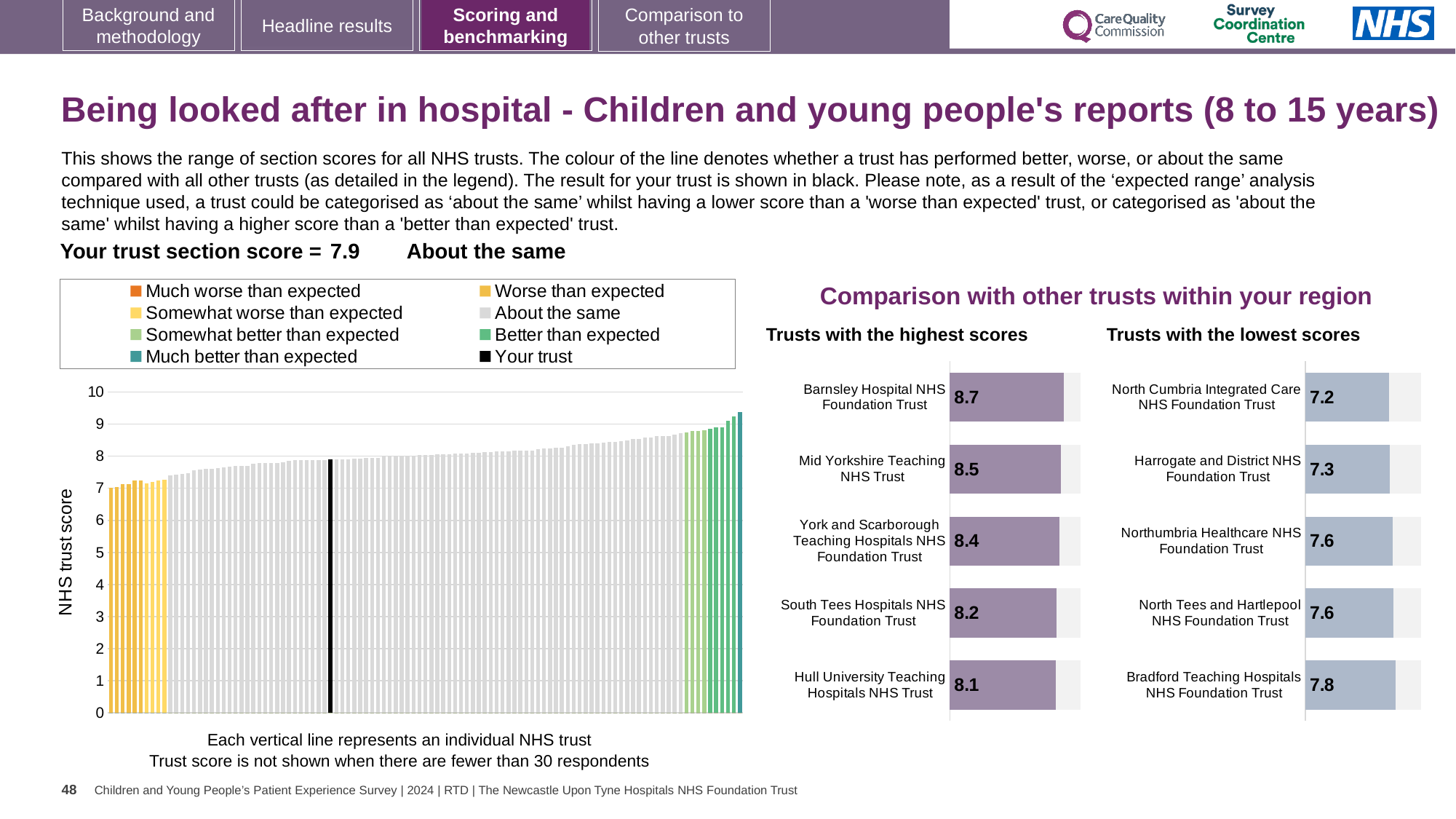
In the 'Trusts with the lowest scores' chart, what is the difference between the scores of Bradford Teaching Hospitals NHS Foundation Trust and North Cumbria Integrated Care NHS Foundation Trust? 0.6 In the 'Trusts with the highest scores' chart, what is the difference between the scores of Barnsley Hospital NHS Foundation Trust and South Tees Hospitals NHS Foundation Trust? 0.5 In the main chart on the left showing all NHS trusts, what is the section score for your trust (the black line)? 7.9 In the 'Trusts with the lowest scores' chart, which trust has the highest score shown? Bradford Teaching Hospitals NHS Foundation Trust In the main chart on the left, do the trust scores rise or fall from left to right? rise In the 'Trusts with the highest scores' chart, which trust has the lowest score shown? Hull University Teaching Hospitals NHS Trust How many entries does the legend of the main chart on the left list? 8 How many trusts are listed in the 'Trusts with the highest scores' chart? 5 In the 'Trusts with the highest scores' chart, what is the score for Barnsley Hospital NHS Foundation Trust? 8.7 Which is larger: the score for Mid Yorkshire Teaching NHS Trust in the highest scores chart or the score for Northumbria Healthcare NHS Foundation Trust in the lowest scores chart? Mid Yorkshire Teaching NHS Trust In the 'Trusts with the lowest scores' chart, what is the score for Harrogate and District NHS Foundation Trust? 7.3 In the 'Trusts with the lowest scores' chart, which trust has the lowest score? North Cumbria Integrated Care NHS Foundation Trust